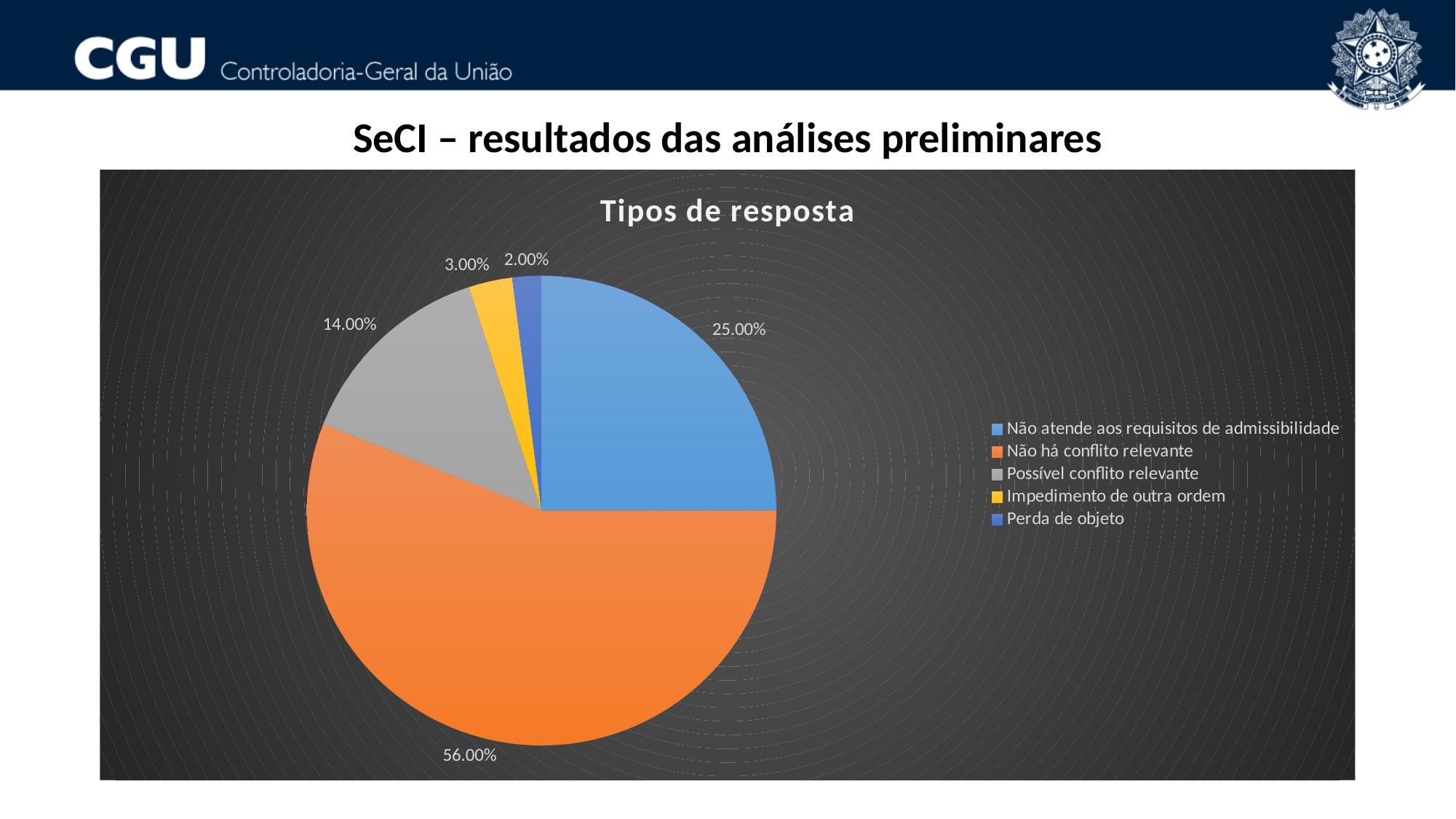
What is the title of the chart? Tipos de resposta What is the difference in percentage points between 'Não há conflito relevante' and 'Não atende aos requisitos de admissibilidade'? 31.00% What percentage of the pie is 'Perda de objeto'? 2.00% What percentage of the pie is 'Impedimento de outra ordem'? 3.00% Which is larger: 'Possível conflito relevante' or 'Impedimento de outra ordem'? Possível conflito relevante What percentage of the pie is 'Não atende aos requisitos de admissibilidade'? 25.00% How many categories does the legend list? 5 What percentage of the pie is 'Possível conflito relevante'? 14.00% Which category has the largest share of the pie? Não há conflito relevante What type of chart is shown on the slide? pie chart What percentage of the pie is 'Não há conflito relevante'? 56.00% Which category has the smallest share of the pie? Perda de objeto